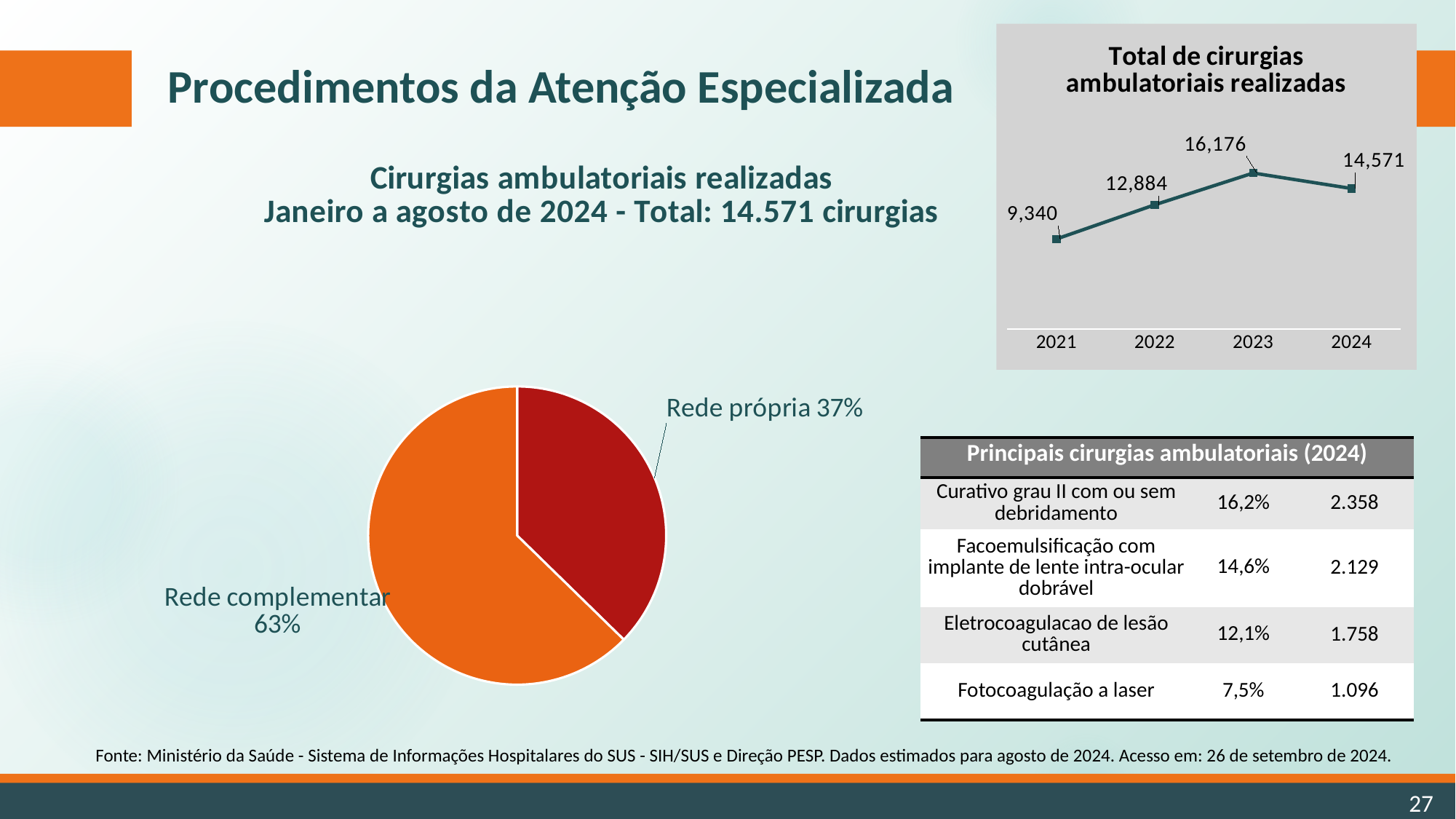
What kind of chart is the one on the left showing 'Rede própria' and 'Rede complementar'? Pie chart In the line chart 'Total de cirurgias ambulatoriais realizadas', what is the value for 2023? 16,176 What kind of chart is 'Total de cirurgias ambulatoriais realizadas'? Line chart In the line chart 'Total de cirurgias ambulatoriais realizadas', how many years are plotted? 4 In the line chart 'Total de cirurgias ambulatoriais realizadas', do the values rise or fall from 2021 to 2023? Rise In the line chart 'Total de cirurgias ambulatoriais realizadas', which year has the highest value? 2023 In the pie chart on the left, what share does 'Rede própria' have? 37% In the pie chart on the left, which slice is larger, 'Rede própria' or 'Rede complementar'? Rede complementar In the line chart 'Total de cirurgias ambulatoriais realizadas', is the value for 2022 larger than the value for 2024? No In the line chart 'Total de cirurgias ambulatoriais realizadas', which year has the lowest value? 2021 In the line chart 'Total de cirurgias ambulatoriais realizadas', what is the value for 2021? 9,340 In the line chart 'Total de cirurgias ambulatoriais realizadas', what is the difference between the 2023 and 2024 values? 1,605